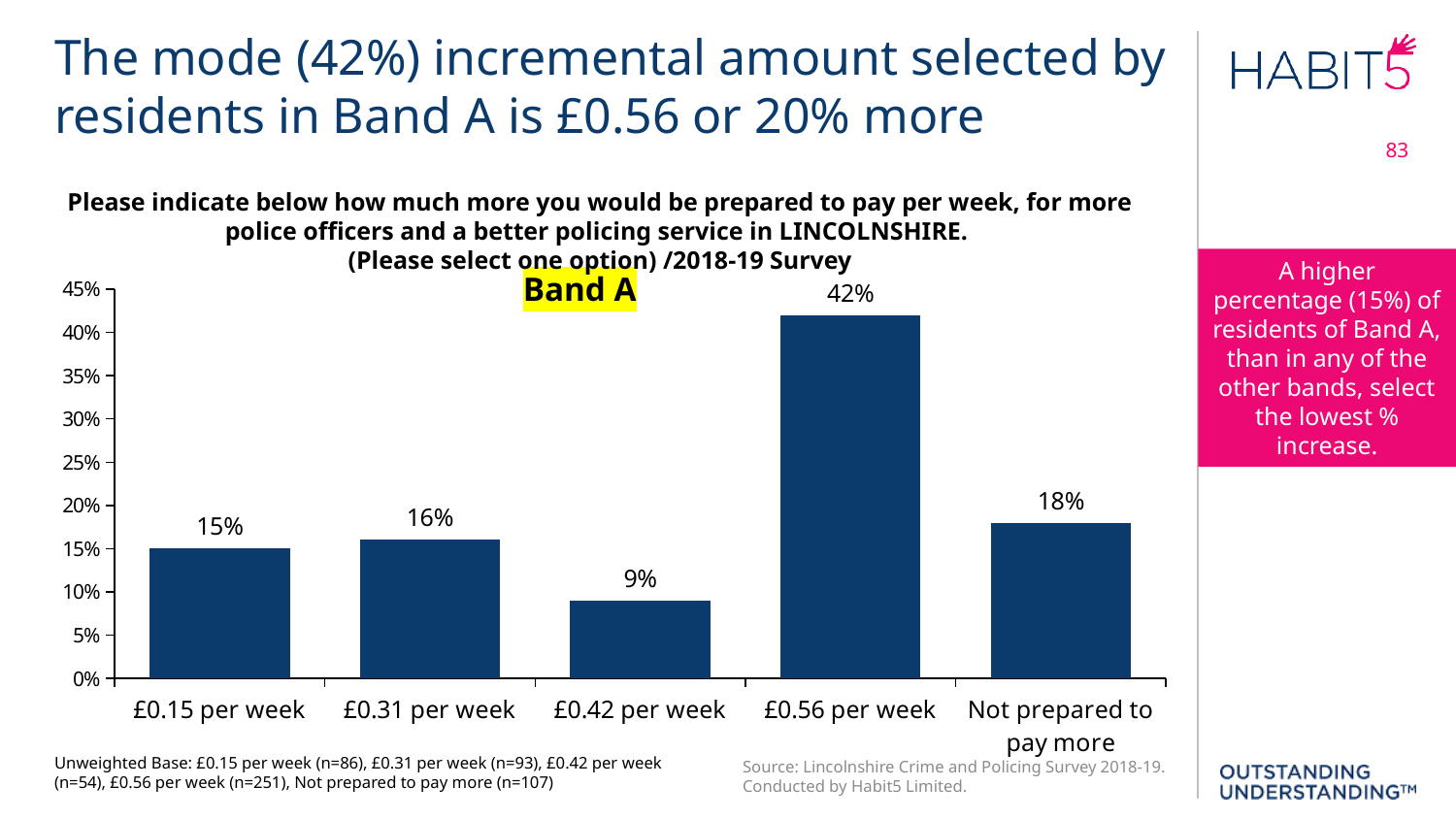
Which option has the highest percentage in the Band A chart? £0.56 per week What percentage of Band A residents were not prepared to pay more? 18% What type of chart is shown on the slide? Bar chart What is the difference in percentage points between £0.31 per week and £0.15 per week? 1 How many options are shown on the x axis of the chart? 5 What is the difference in percentage points between £0.56 per week and £0.42 per week? 33 Which band is the chart about, as shown in the highlighted label? Band A Is the value for £0.56 per week greater or less than 40%? greater Which is larger: the percentage for 'Not prepared to pay more' or for £0.31 per week? Not prepared to pay more What percentage of Band A residents selected £0.56 per week? 42% What percentage of Band A residents selected £0.15 per week? 15% Which option has the lowest percentage in the Band A chart? £0.42 per week